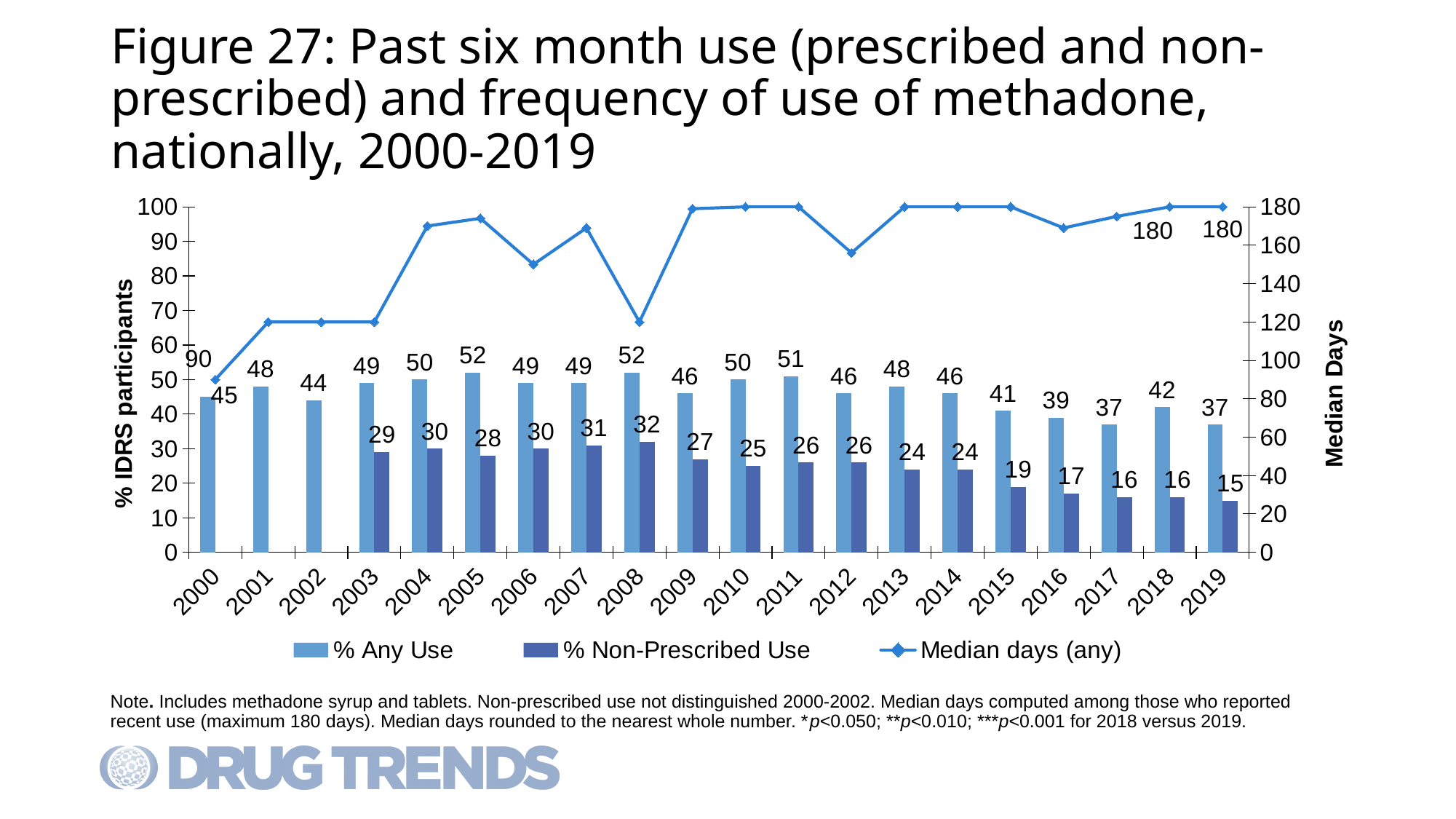
How many years are shown on the x axis? 20 What is the Median days (any) value for 2000? 90 What is the difference between % Any Use and % Non-Prescribed Use in 2019? 22 What kind of chart is this? Combined bar and line chart What is the % Non-Prescribed Use value for 2013? 24 In which year is % Non-Prescribed Use highest? 2008 In which year is % Non-Prescribed Use lowest? 2019 Is the Median days (any) value for 2008 greater or less than 140? less Does % Non-Prescribed Use rise or fall from 2008 to 2019? fall What is the % Any Use value for 2005? 52 Which year has a higher % Any Use, 2016 or 2018? 2018 How many series does the legend list? 3